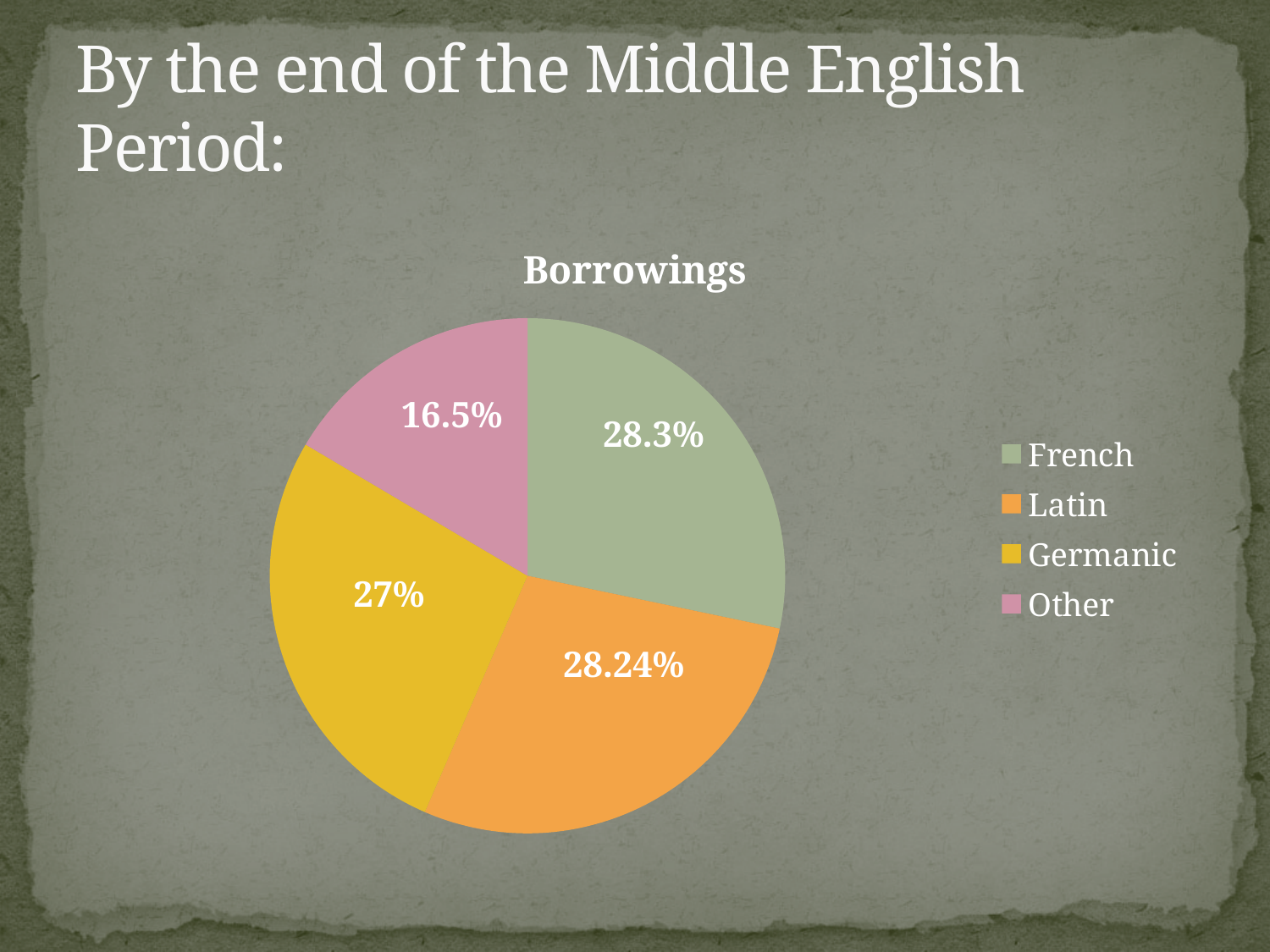
What type of chart is shown on the slide? Pie chart Which category has the largest share of borrowings according to the data labels? French What percentage is shown for Latin borrowings? 28.24% What value is labelled on the Germanic slice? 27% What is the title of the chart? Borrowings What share of the pie is labelled 'Other'? 16.5% Which category has the smallest slice of the pie? Other What is the difference in percentage points between the French and Other slices? 11.8 What is the difference in percentage points between the Germanic and Other slices? 10.5 How many categories are shown in the pie chart? 4 Which is larger, the Germanic share or the Other share? Germanic What percentage of borrowings does the French slice represent? 28.3%